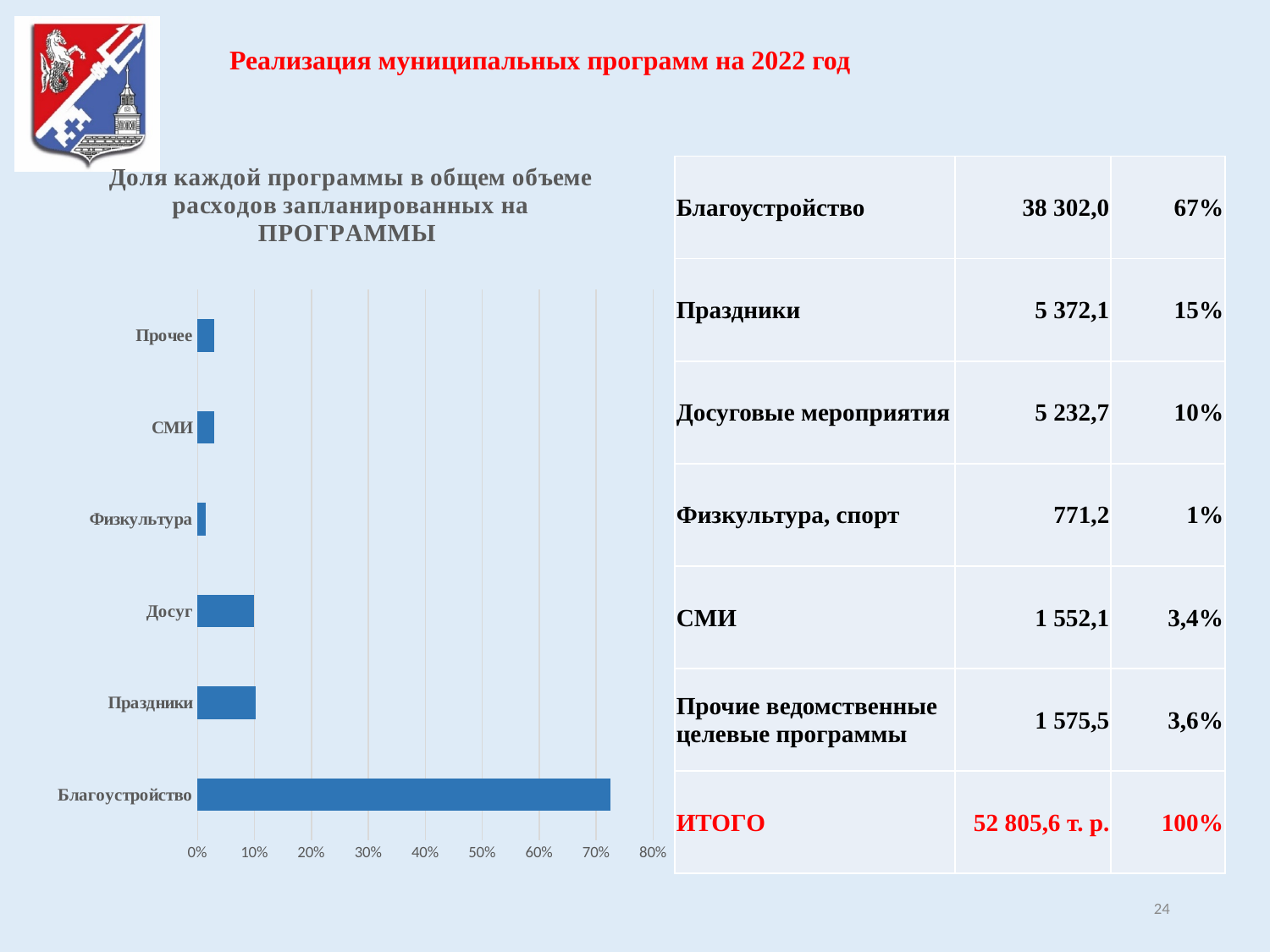
Which category has the highest value in the bar chart? Благоустройство How many categories are plotted in the bar chart? 6 What colour are the bars in the chart? blue In the bar chart, which is larger: the value for Благоустройство or the value for Досуг? Благоустройство In the bar chart, which is larger: the value for Досуг or the value for Прочее? Досуг Is the value for Благоустройство in the bar chart greater or less than 60%? greater Which category has the lowest value in the bar chart? Физкультура Is the value for Досуг in the bar chart greater or less than 20%? less What kind of chart is shown on the slide? bar chart Is the value for Праздники in the bar chart greater or less than 30%? less What is the title of the bar chart? Доля каждой программы в общем объеме расходов запланированных на ПРОГРАММЫ